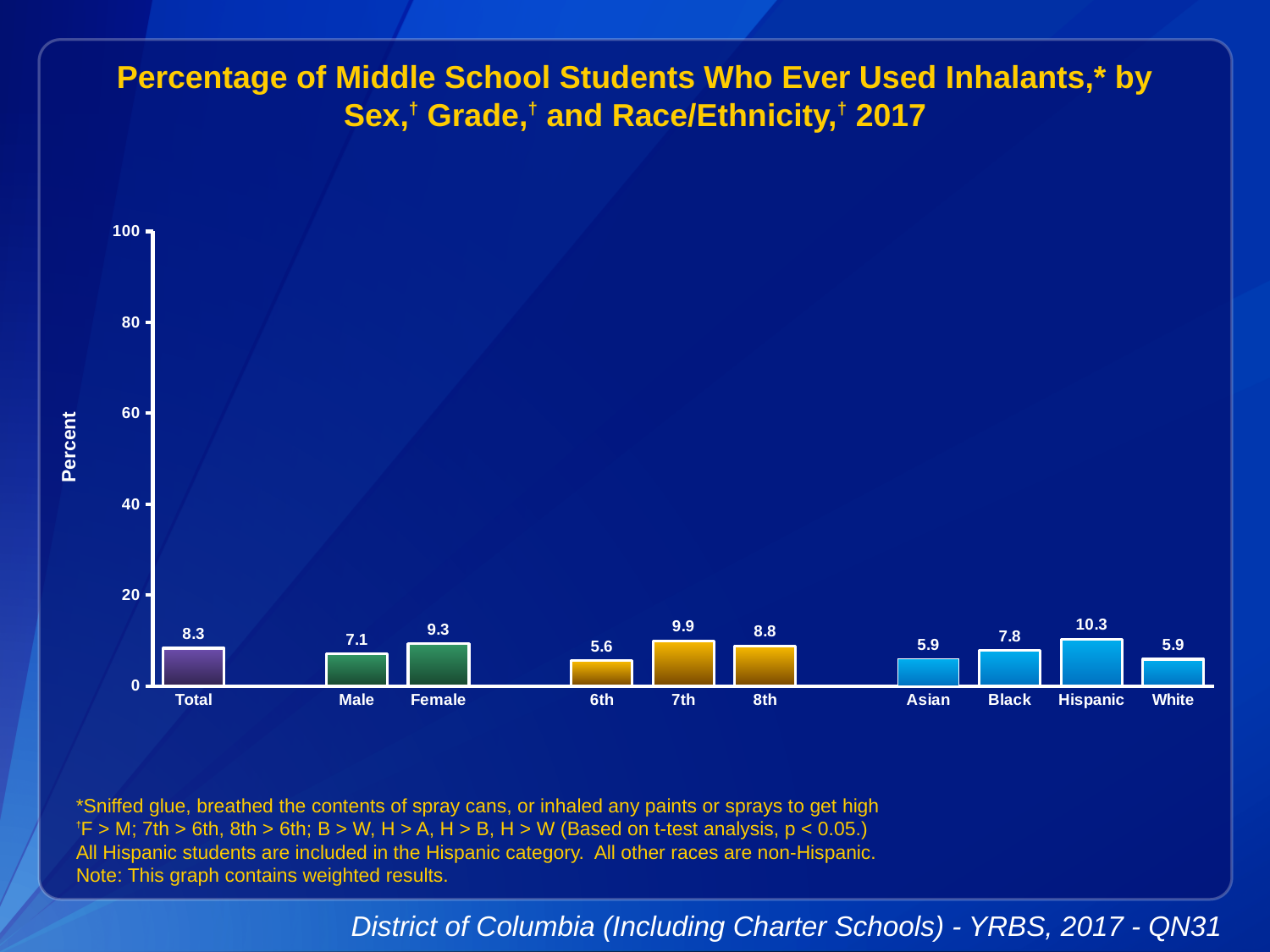
What is the value for 7th grade? 9.9 What kind of chart is this? bar chart What is the value for Total? 8.3 What is the label of the y axis? Percent Which category has the highest value? Hispanic Is the value for Black greater or less than 20? less What is the value for Female? 9.3 Which is larger, the value for 8th grade or the value for 6th grade? 8th What is the difference between the Female and Male values? 2.2 How many categories are shown on the x axis? 10 Which category has the lowest value? 6th What is the value for Hispanic? 10.3